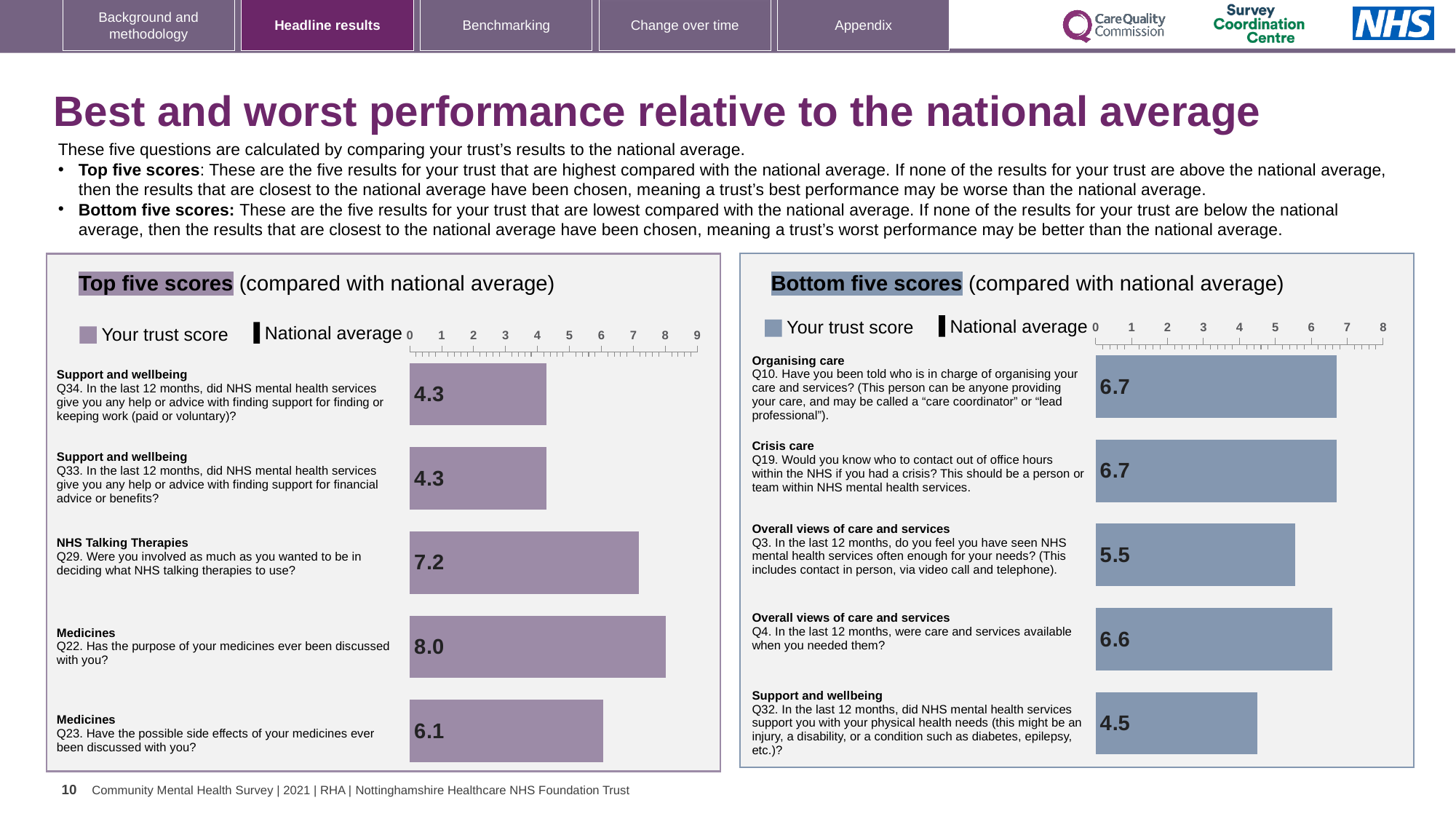
In the Bottom five scores chart, what is the trust score for Q3 (do you feel you have seen NHS mental health services often enough for your needs?)? 5.5 In the Top five scores chart, what is the difference between the trust scores for Q22 and Q23? 1.9 In the Top five scores chart, what is the trust score for Q29 (Were you involved as much as you wanted to be in deciding what NHS talking therapies to use?)? 7.2 In the Bottom five scores chart, is the trust score for Q19 greater or less than 6? greater In the Top five scores chart, what is the trust score for Q22 (Has the purpose of your medicines ever been discussed with you?)? 8.0 In the Bottom five scores chart, what is the difference between the trust scores for Q10 and Q32? 2.2 In the Top five scores chart, what is the lowest trust score shown? 4.3 How many questions are shown in the Top five scores chart? 5 In the Top five scores chart, which question has the highest trust score? Q22 (Medicines) In the Bottom five scores chart, which question has the lowest trust score? Q32 (Support and wellbeing) In the Bottom five scores chart, which has the larger trust score: Q4 or Q3? Q4 What type of chart is used in the Bottom five scores panel? Bar chart